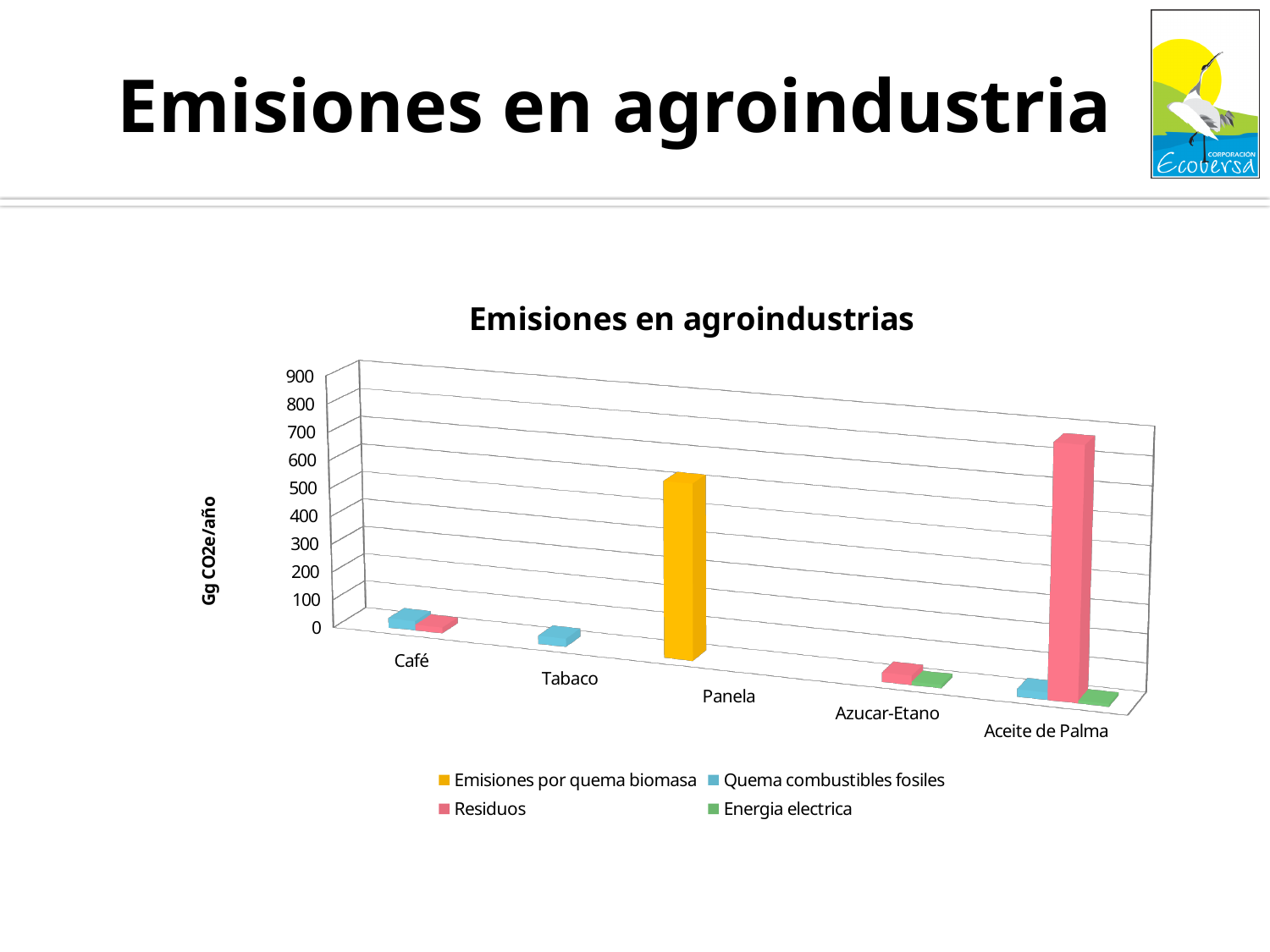
Which series has the tallest bar for Aceite de Palma? Residuos What is the label on the vertical axis of the chart? Gg CO2e/año Which series has the only visible bar for Panela? Emisiones por quema biomasa What kind of chart is shown on the slide? Bar chart Is the Residuos value for Aceite de Palma greater or less than 400? greater Which is larger: the Emisiones por quema biomasa bar for Panela or the Residuos bar for Aceite de Palma? Residuos bar for Aceite de Palma Is the Quema combustibles fosiles value for Café greater or less than 100? less How many categories are shown on the x axis of the chart? 5 What is the title of the chart? Emisiones en agroindustrias How many series does the chart legend list? 4 Is the Emisiones por quema biomasa value for Panela greater or less than 200? greater Which category has the tallest bar in the chart? Aceite de Palma